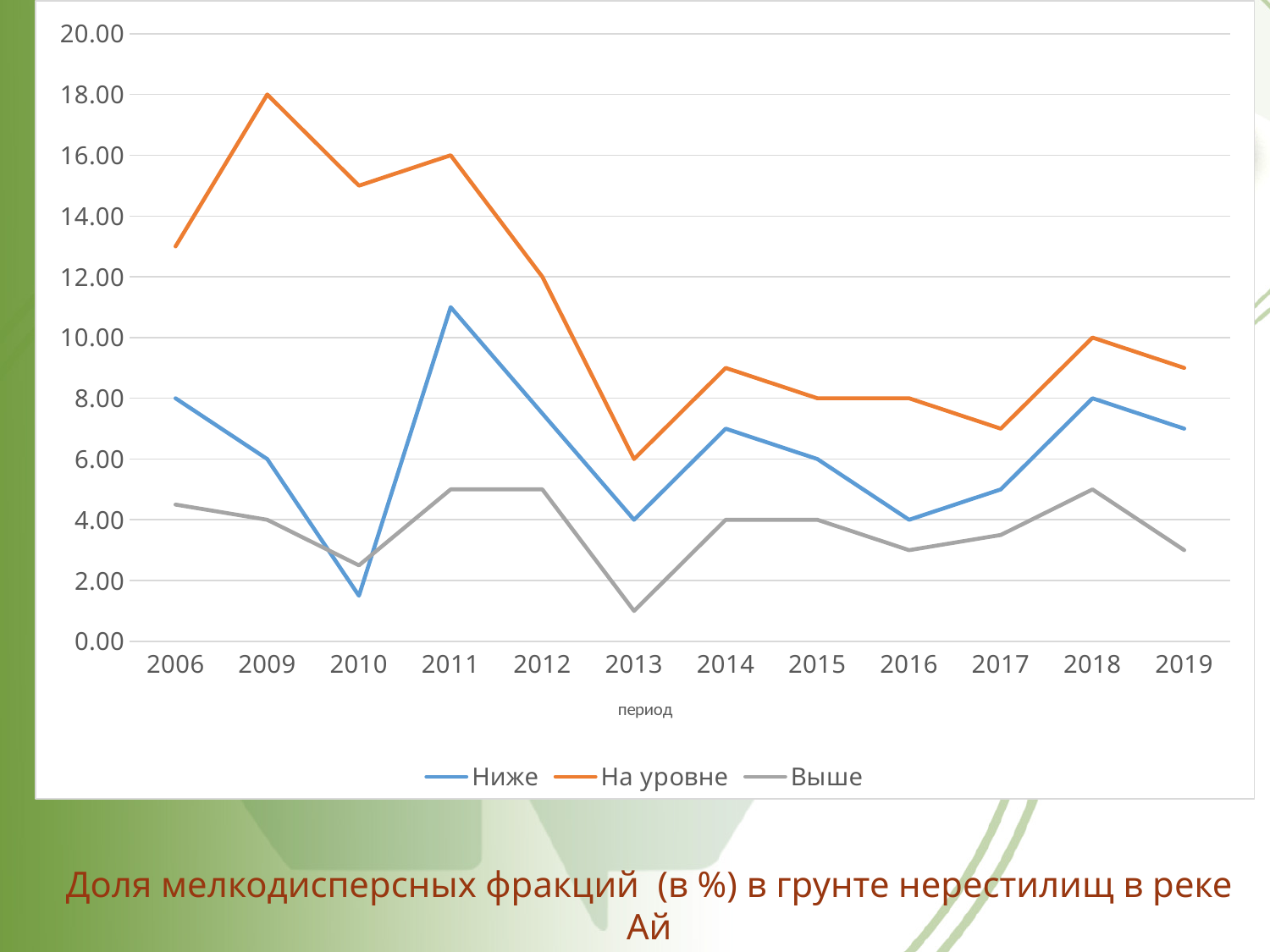
What is the value of the 'На уровне' series in 2009? 18.00 How many series does the legend list? 3 In which year does the 'Ниже' series reach its lowest value? 2010 What is the value of the 'Ниже' series in 2006? 8.00 Does the 'На уровне' series rise or fall from 2011 to 2013? fall What label is shown on the x axis of the chart? период In which year does the 'На уровне' series reach its highest value? 2009 How many periods are plotted along the x axis? 12 Which series has the larger value in 2011, 'Ниже' or 'На уровне'? На уровне What kind of chart is shown on the slide? line chart Is the value of the 'Ниже' series in 2011 greater or less than 10.00? greater In which year does the 'Выше' series reach its lowest value? 2013